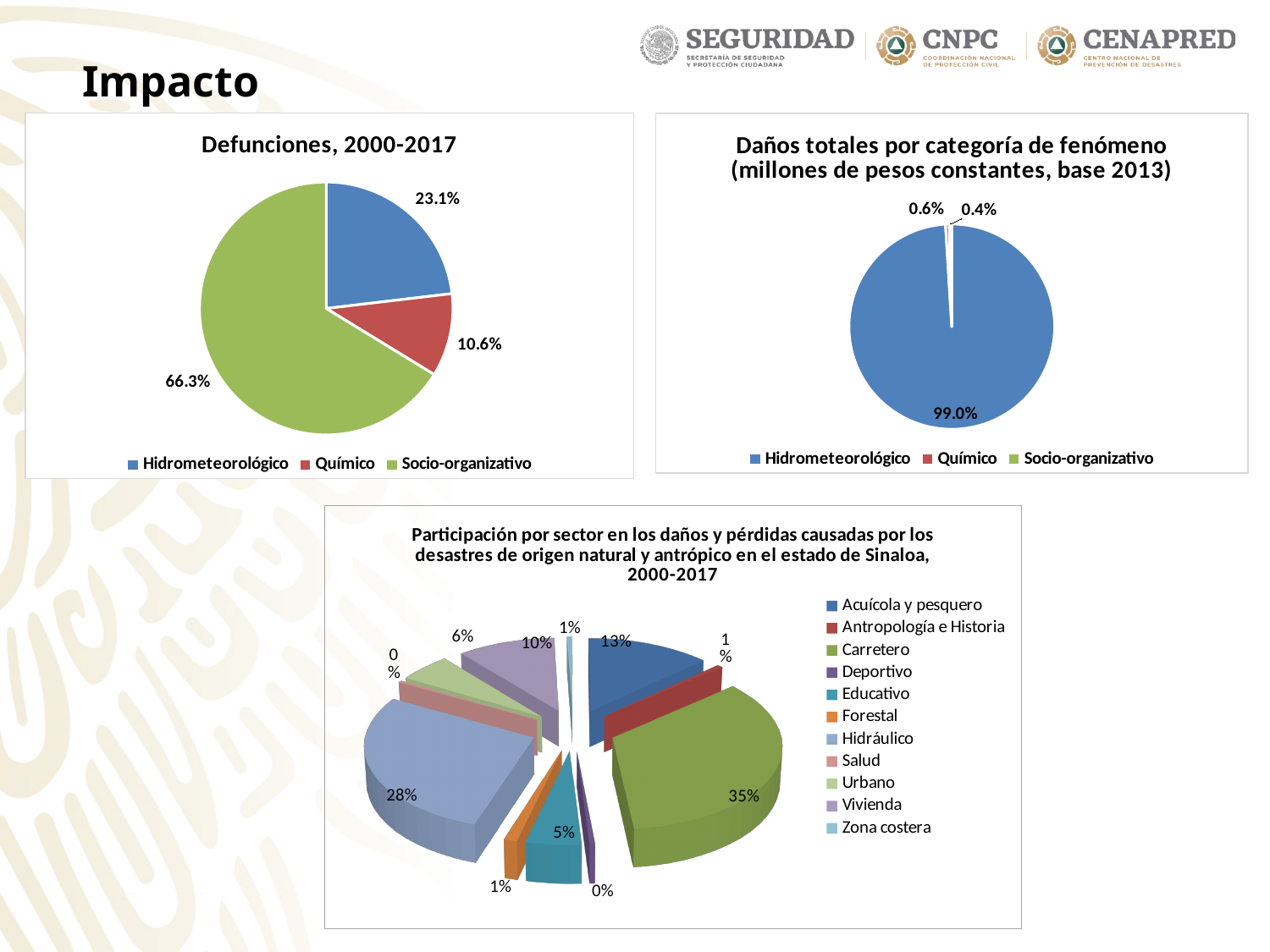
In the bottom chart titled "Participación por sector...", which sector has the largest share? Carretero In the chart titled "Defunciones, 2000-2017", which category has the smallest share? Químico What kind of chart is the chart at the bottom of the slide, titled "Participación por sector..."? Pie chart In the chart titled "Defunciones, 2000-2017", what is the difference in percentage points between Socio-organizativo and Hidrometeorológico? 43.2 In the chart titled "Defunciones, 2000-2017", which category has the largest share? Socio-organizativo In the bottom chart titled "Participación por sector...", what percentage is shown for Carretero? 35% In the chart titled "Daños totales por categoría de fenómeno", what percentage is shown for Hidrometeorológico? 99.0% In the chart titled "Defunciones, 2000-2017", what percentage is shown for Hidrometeorológico? 23.1% In the chart titled "Daños totales por categoría de fenómeno", how many categories does the legend list? 3 In the bottom chart titled "Participación por sector...", how many sectors does the legend list? 11 In the chart titled "Defunciones, 2000-2017", what percentage is shown for Químico? 10.6% In the chart titled "Defunciones, 2000-2017", what share of the pie is Socio-organizativo? 66.3%